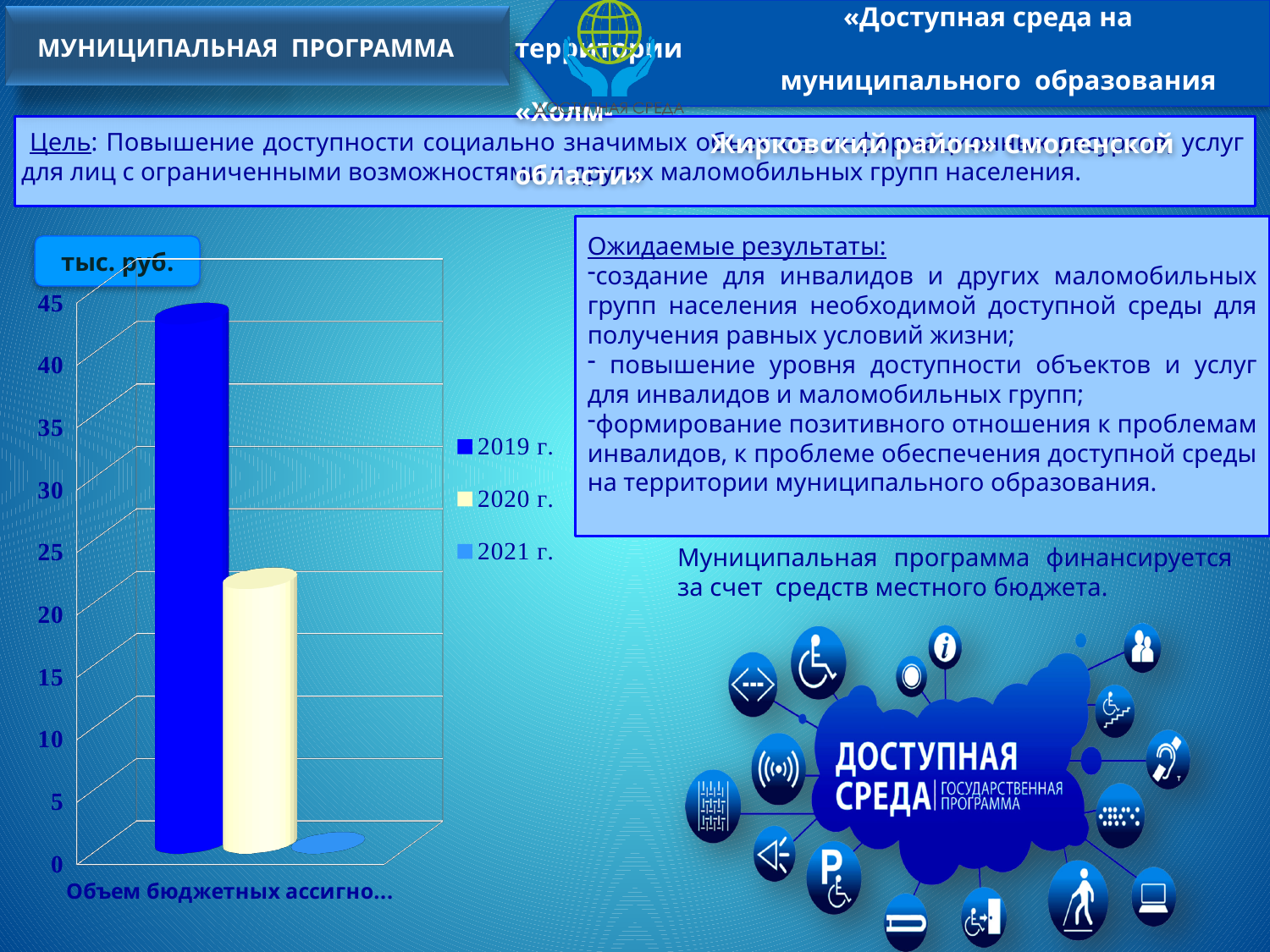
Which year has the highest value in the chart? 2019 г. Which is larger, the value for 2019 г. or the value for 2020 г.? 2019 г. Do the values rise or fall from 2019 г. to 2021 г.? fall Is the value for 2021 г. greater or less than 5? less Is the value for 2019 г. greater or less than 40? greater What unit is shown in the label above the chart? тыс. руб. Which year has the lowest value in the chart? 2021 г. What kind of chart is shown on the slide? bar chart Is the value for 2020 г. greater or less than 25? less Which is larger, the value for 2020 г. or the value for 2021 г.? 2020 г. How many series does the chart legend list? 3